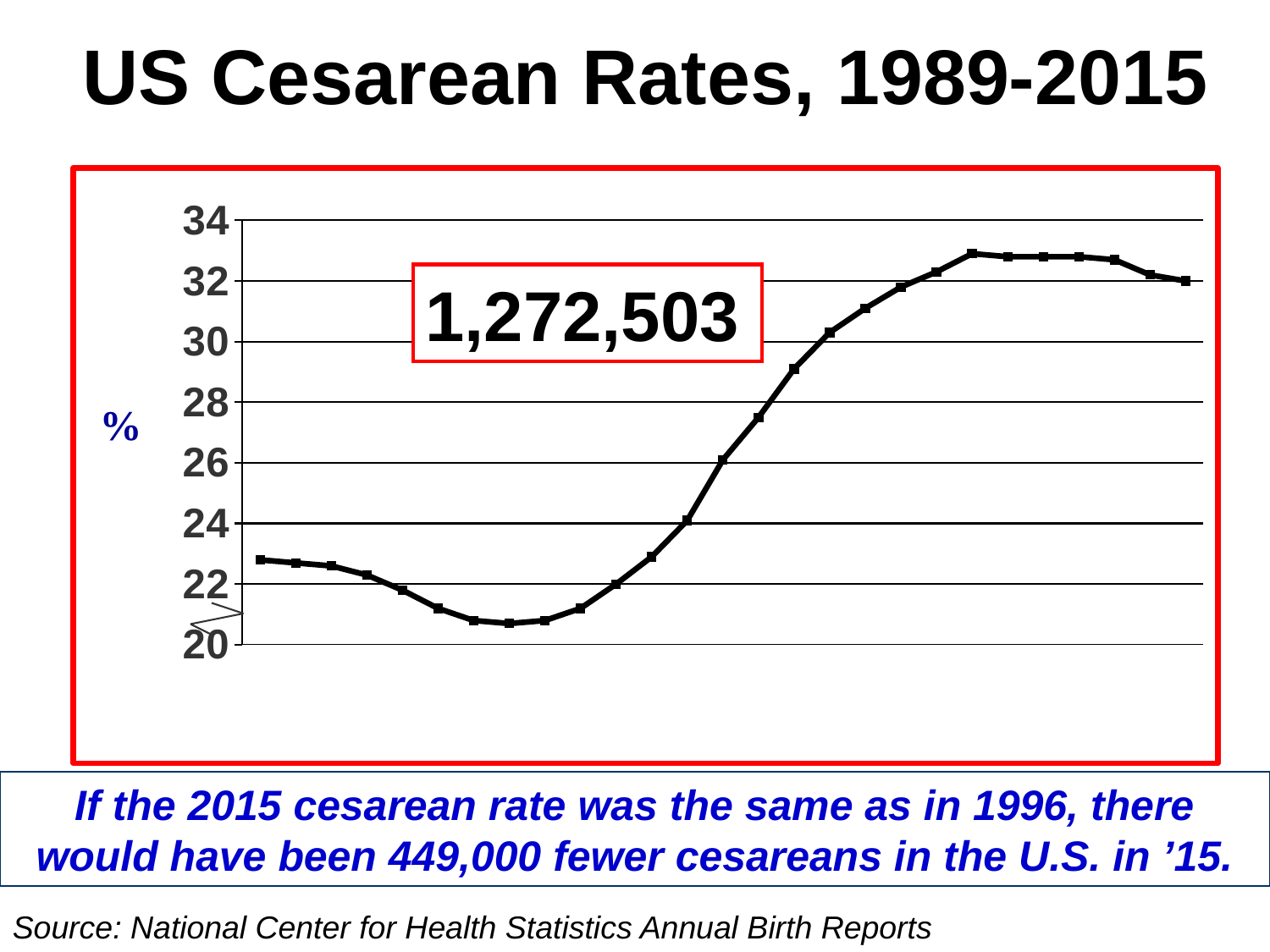
How many data points are plotted on the line? 27 Is the lowest point on the line greater or less than 22? less Is the highest point on the line greater or less than 32? greater Overall, does the cesarean rate rise or fall from the start of the series to the end? rise Is the value for the last point on the line (2015) greater or less than 30? greater Does the line fall or rise over the first several points before reaching its lowest value? fall What is the title of the chart? US Cesarean Rates, 1989-2015 Which is larger, the value at the first point (1989) or the value at the last point (2015)? the last point (2015) What kind of chart is shown on the slide? line chart What number is printed in the red box inside the chart? 1,272,503